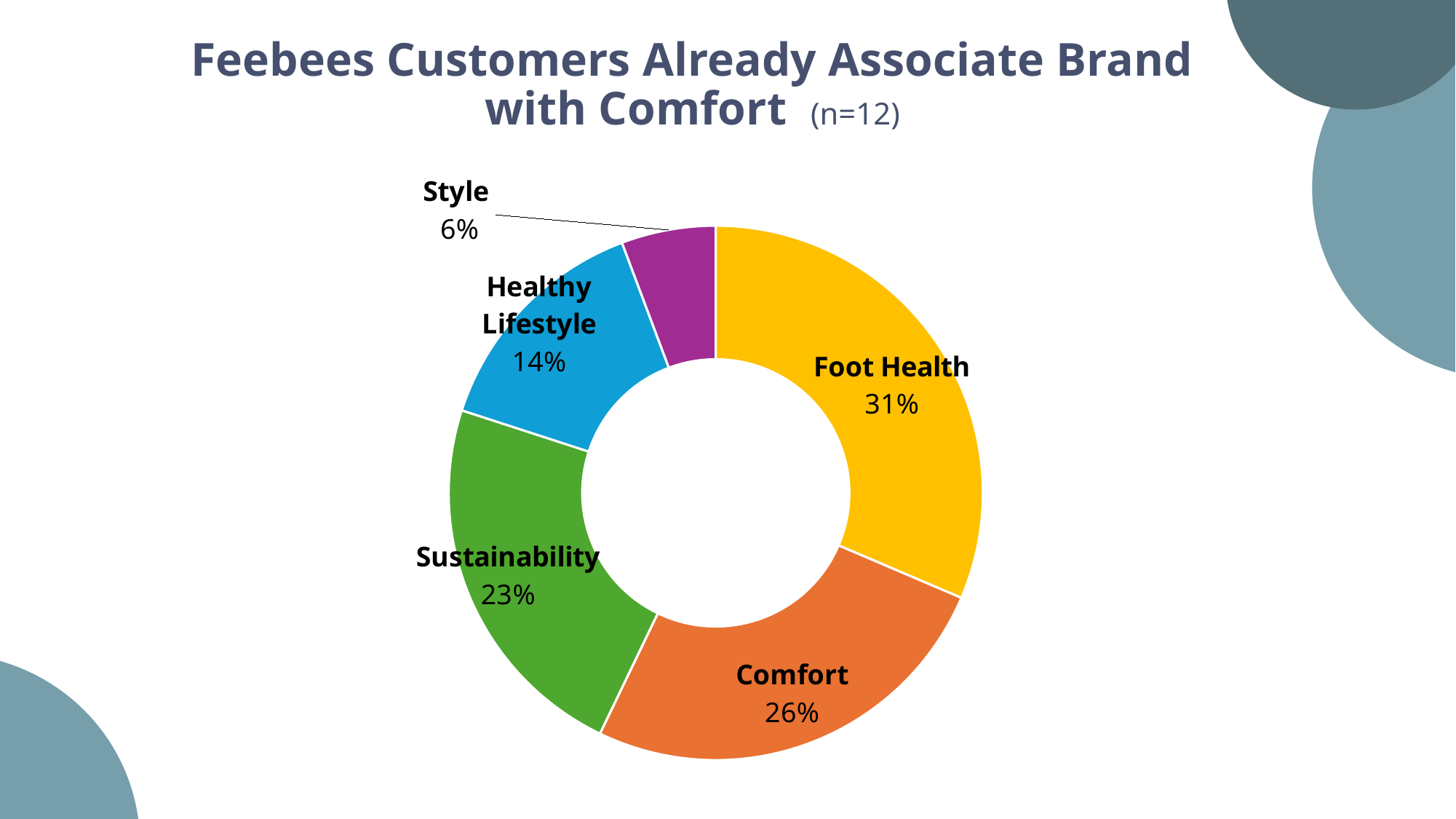
How many categories are shown in the chart? 5 What share of the pie does Style represent? 6% What is the difference in percentage points between Foot Health and Comfort? 5 What is the value shown for Healthy Lifestyle? 14% What is the value shown for Comfort? 26% Which category has the smallest share? Style What kind of chart is shown on the slide? Pie chart (donut) What sample size is stated in the slide title? n=12 Which is larger, Sustainability or Healthy Lifestyle? Sustainability What share of the pie does Foot Health represent? 31% Which category has the largest share? Foot Health What is the value shown for Sustainability? 23%